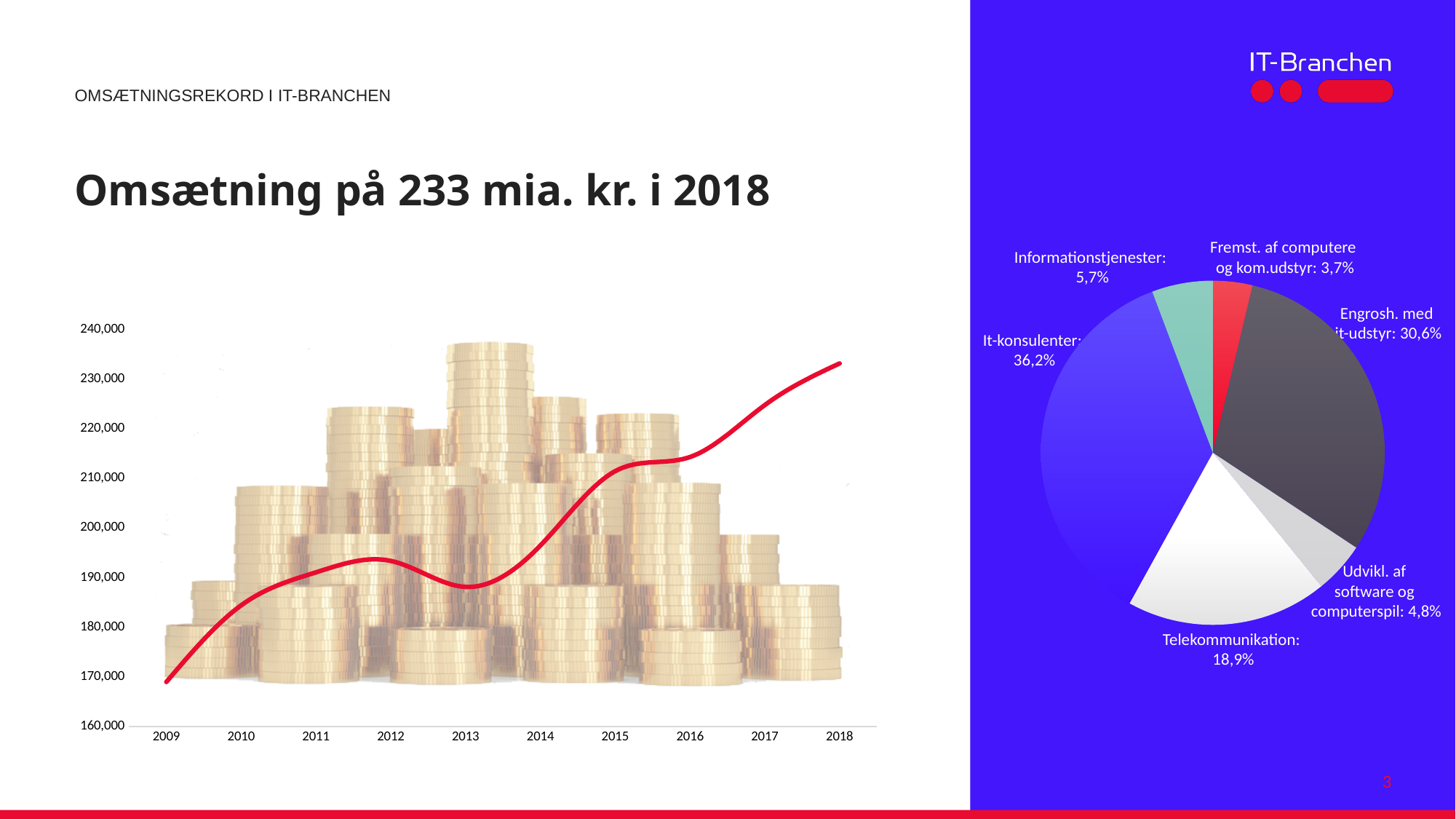
How many slices does the pie chart on the right have? 6 In the pie chart on the right, what is the difference in percentage points between It-konsulenter and Engrosh. med it-udstyr? 5,6 In the pie chart on the right, which category has the largest share? It-konsulenter In the pie chart on the right, what share does Telekommunikation have? 18,9% In the line chart on the left, does the value generally rise or fall from 2013 to 2018? rise In the pie chart on the right, what share does It-konsulenter have? 36,2% How many years are shown on the x axis of the line chart on the left? 10 In the line chart on the left, is the value for 2018 greater or less than 230,000? greater In the pie chart on the right, what share does Udvikl. af software og computerspil have? 4,8% In the pie chart on the right, which has the larger share: Informationstjenester or Udvikl. af software og computerspil? Informationstjenester What kind of chart is shown on the left side of the slide? Line chart In the pie chart on the right, which category has the smallest share? Fremst. af computere og kom.udstyr